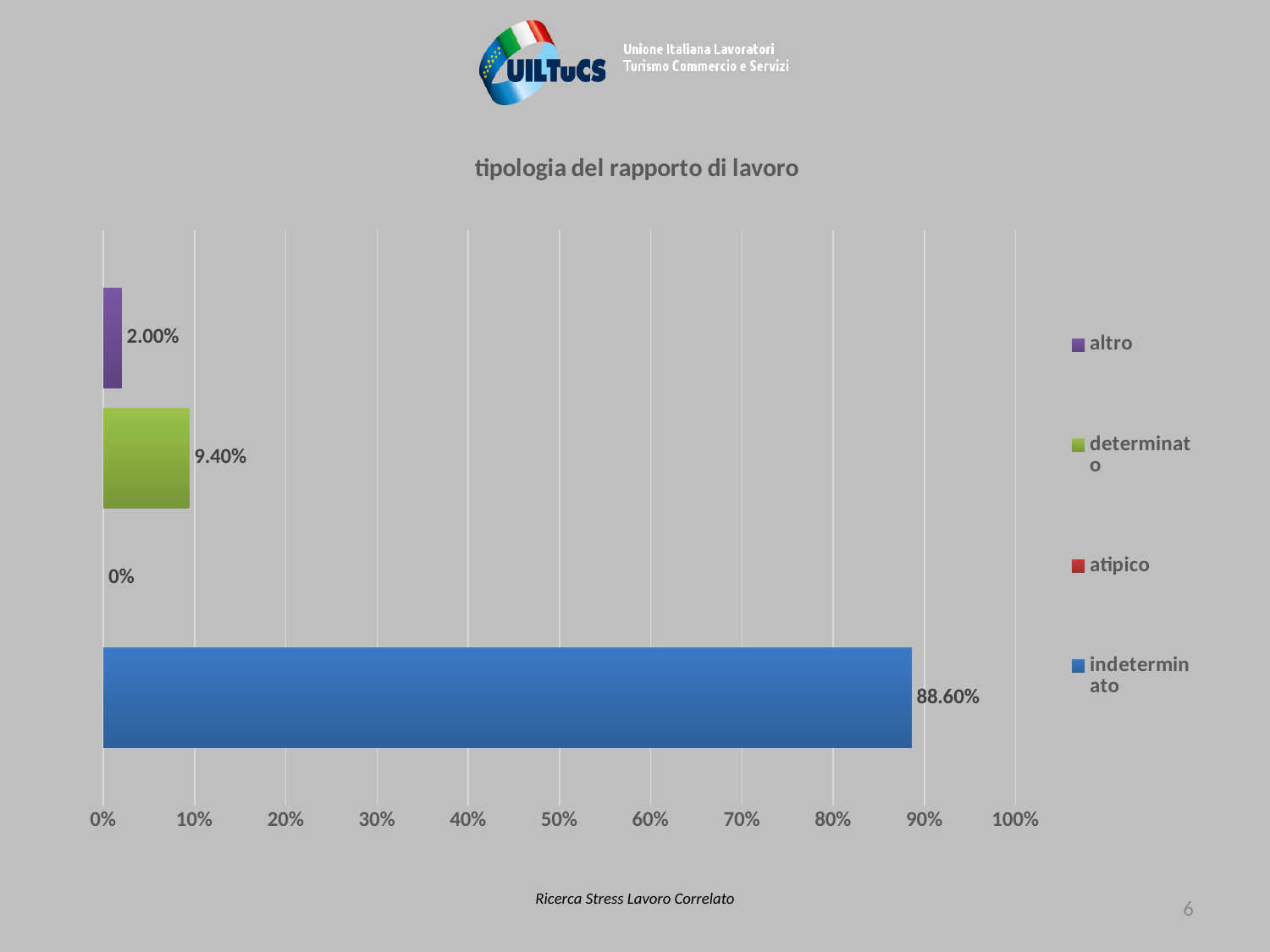
What kind of chart is shown on the slide? bar chart What is the title of the chart? tipologia del rapporto di lavoro What is the value for atipico? 0% What is the value for altro? 2.00% What is the difference between the values for determinato and altro? 7.40% What is the value for determinato? 9.40% Which category has the highest value? indeterminato What is the difference between the values for indeterminato and determinato? 79.20% Which is larger, the value for determinato or the value for altro? determinato What is the value for indeterminato? 88.60% How many categories does the legend list? 4 Which category has the lowest value? atipico